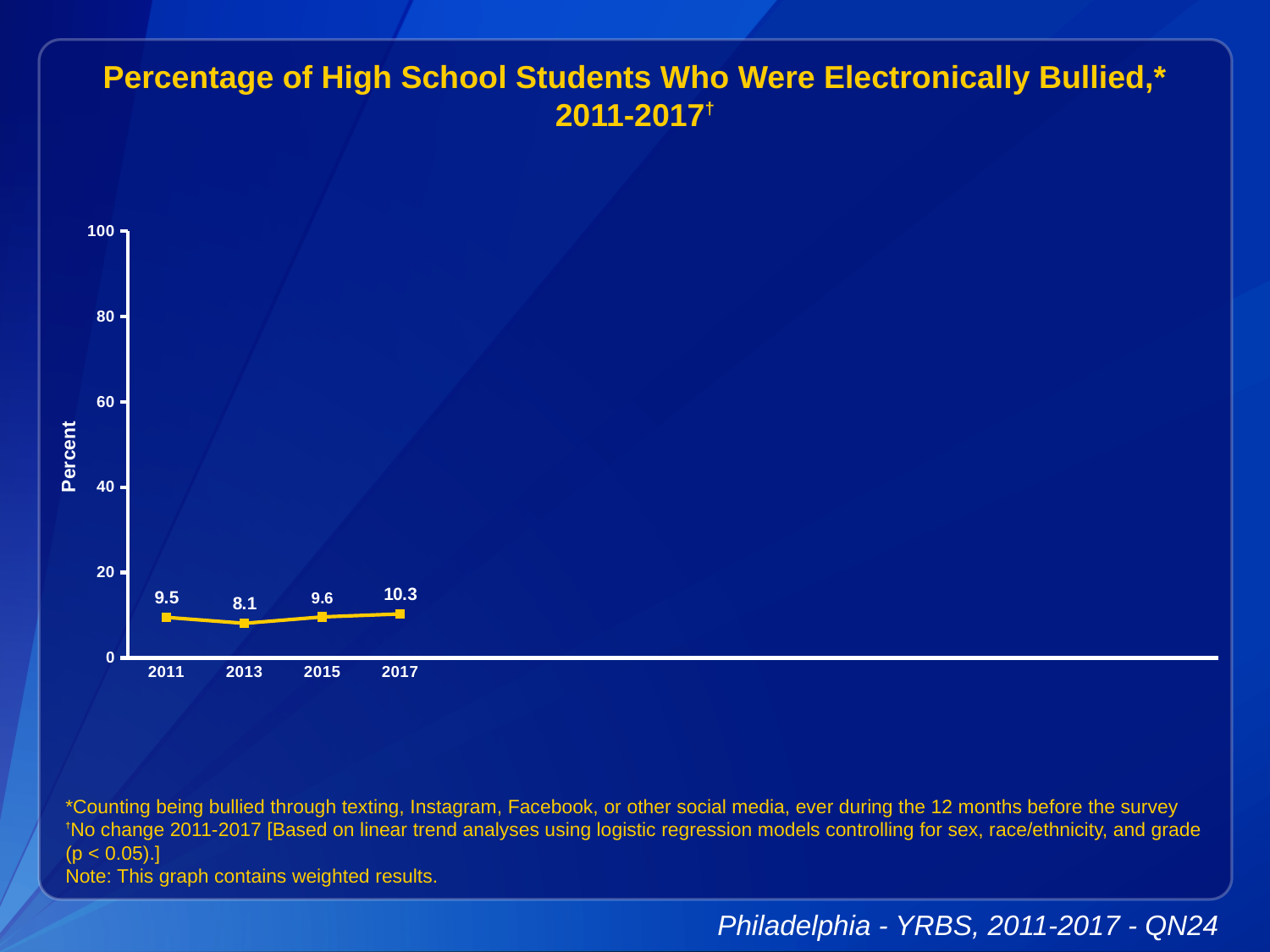
What kind of chart is shown on the slide? line chart Which year has a larger value, 2011 or 2015? 2015 What is the label on the y axis of the chart? Percent Which year has the highest percentage of students electronically bullied? 2017 How many years are plotted on the chart? 4 Which year has the lowest percentage of students electronically bullied? 2013 Is the value for 2017 greater or less than 20? less What percentage of high school students were electronically bullied in 2017? 10.3 What percentage of high school students were electronically bullied in 2013? 8.1 What percentage of high school students were electronically bullied in 2011? 9.5 What is the difference between the 2017 and 2013 values? 2.2 Does the value rise or fall from 2013 to 2017? rise